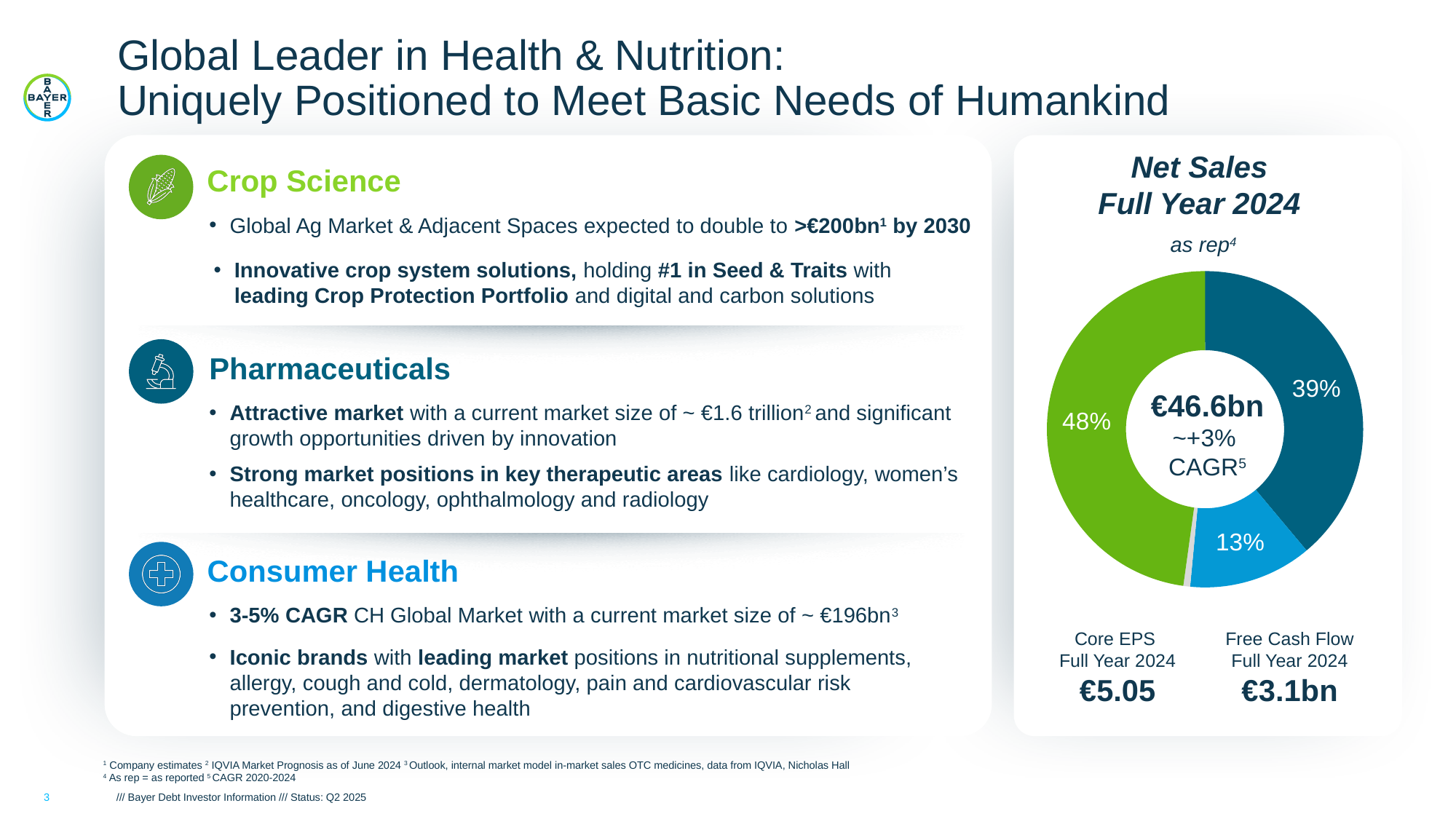
In the Net Sales Full Year 2024 donut chart, what is the difference in percentage points between the largest slice (48%) and the smallest slice (13%)? 35 percentage points What share does the light blue slice represent in the Net Sales Full Year 2024 donut chart? 13% How many slices does the Net Sales Full Year 2024 donut chart have? 4 What CAGR is printed in the centre of the Net Sales Full Year 2024 donut chart? ~+3% What kind of chart is shown under the title "Net Sales Full Year 2024"? Pie chart (donut) What share does the green slice represent in the Net Sales Full Year 2024 donut chart? 48% What is the title of the donut chart on the right side of the slide? Net Sales Full Year 2024 What is the largest share shown in the Net Sales Full Year 2024 donut chart? 48% What share does the dark blue slice represent in the Net Sales Full Year 2024 donut chart? 39% What total net sales value is printed in the centre of the Net Sales Full Year 2024 donut chart? €46.6bn In the Net Sales Full Year 2024 donut chart, which is larger: the green slice or the dark blue slice? The green slice (48%)